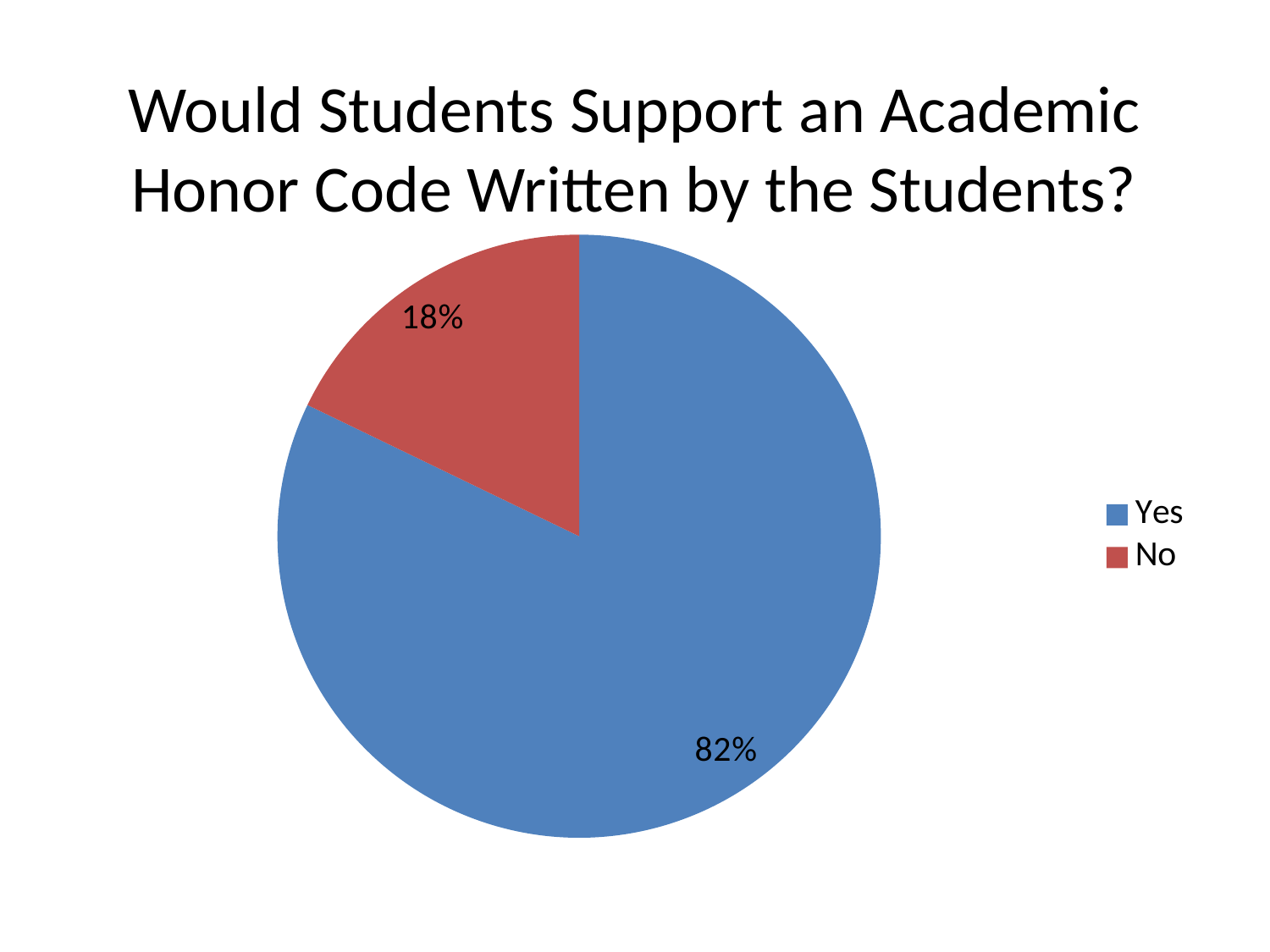
What percentage of students answered Yes? 82% Which response has the smallest share of the pie? No What is the title of the chart? Would Students Support an Academic Honor Code Written by the Students? Which slice is larger, Yes or No? Yes How many entries does the legend list? 2 Which response has the largest share of the pie? Yes What is the difference in percentage points between the Yes and No slices? 64 What colour is the Yes slice? blue What kind of chart is shown on the slide? pie chart What percentage of students answered No? 18% What share of the pie does the No slice represent? 18% How many slices does the pie chart have? 2